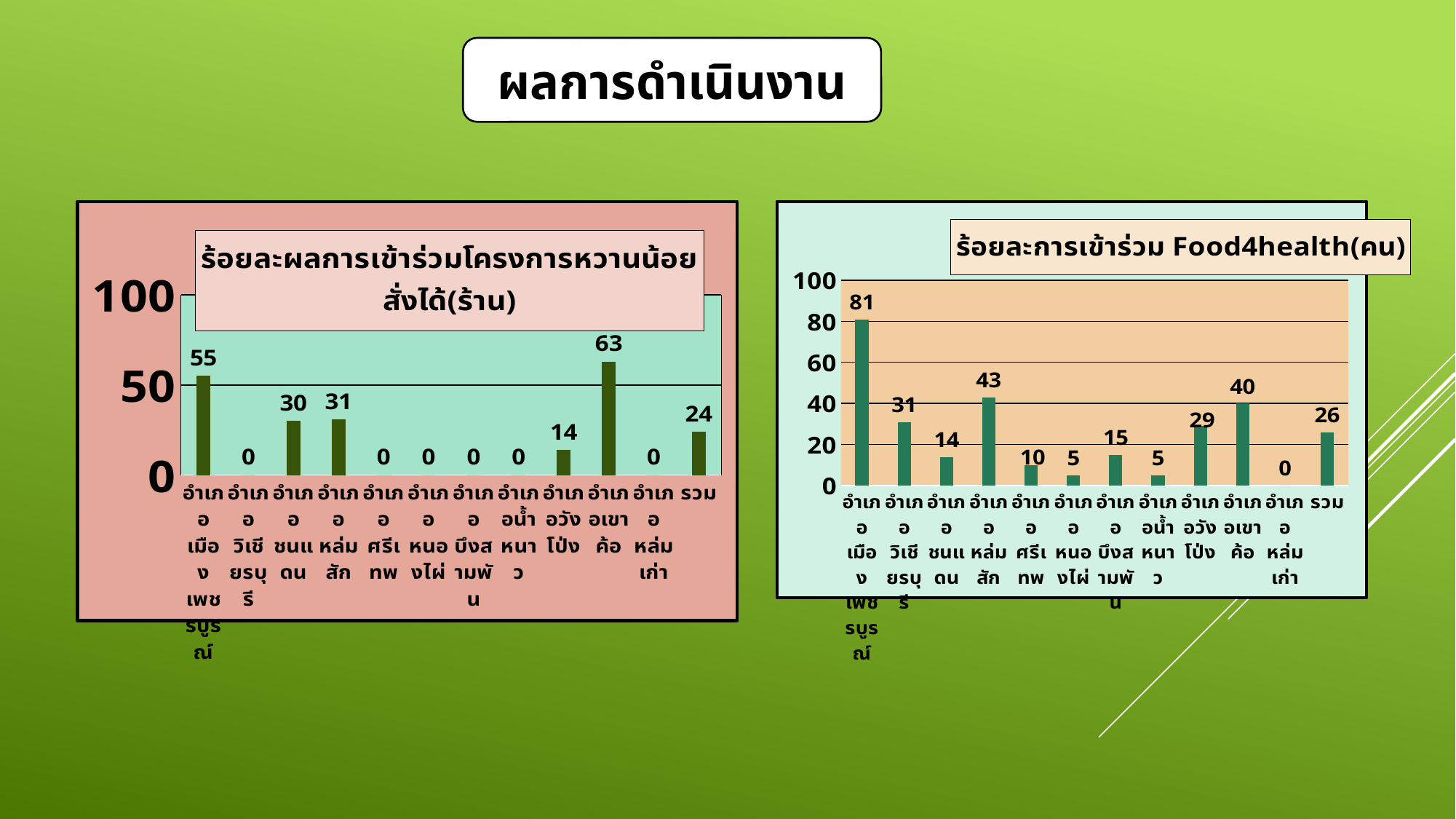
In the left chart (ร้อยละผลการเข้าร่วมโครงการหวานน้อยสั่งได้(ร้าน)), what is the difference between อำเภอเมืองเพชรบูรณ์ and อำเภอชนแดน? 25 In the left chart (ร้อยละผลการเข้าร่วมโครงการหวานน้อยสั่งได้(ร้าน)), how many categories have a value of 0? 6 In the left chart (ร้อยละผลการเข้าร่วมโครงการหวานน้อยสั่งได้(ร้าน)), what is the value for อำเภอเขาค้อ? 63 In the left chart (ร้อยละผลการเข้าร่วมโครงการหวานน้อยสั่งได้(ร้าน)), what is the value for รวม? 24 In the right chart (ร้อยละการเข้าร่วม Food4health(คน)), which is larger, อำเภอวังโป่ง or อำเภอเขาค้อ? อำเภอเขาค้อ In the right chart (ร้อยละการเข้าร่วม Food4health(คน)), what is the value for อำเภอหล่มสัก? 43 In the left chart (ร้อยละผลการเข้าร่วมโครงการหวานน้อยสั่งได้(ร้าน)), how many categories are shown on the x axis? 12 In the left chart (ร้อยละผลการเข้าร่วมโครงการหวานน้อยสั่งได้(ร้าน)), which category has the highest value? อำเภอเขาค้อ What type of chart is the right chart (ร้อยละการเข้าร่วม Food4health(คน))? Bar chart In the right chart (ร้อยละการเข้าร่วม Food4health(คน)), what is the difference between อำเภอวิเชียรบุรี and อำเภอชนแดน? 17 In the right chart (ร้อยละการเข้าร่วม Food4health(คน)), what is the value for อำเภอเมืองเพชรบูรณ์? 81 In the right chart (ร้อยละการเข้าร่วม Food4health(คน)), which category has the lowest value? อำเภอหล่มเก่า